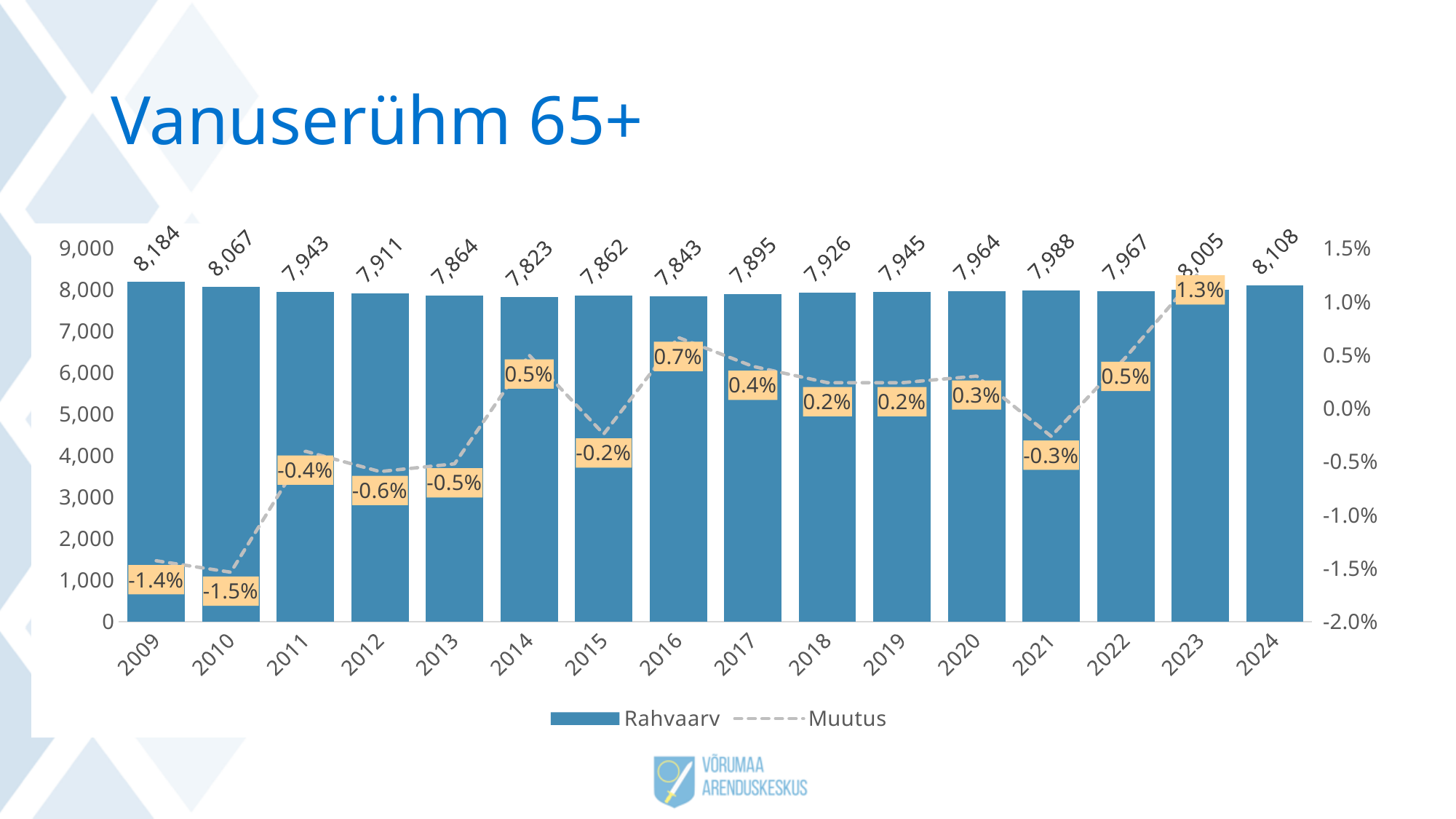
What is the title of the slide? Vanuserühm 65+ What is the Rahvaarv value for 2024? 8,108 How many years are shown on the x axis? 16 What is the Muutus value for 2023? 1.3% Which year has the lowest Rahvaarv value? 2014 How many series does the legend list? 2 What is the Muutus value for 2012? -0.6% Which year has the lowest Muutus value? 2010 What is the Rahvaarv value for 2009? 8,184 Which year has the highest Rahvaarv value? 2009 Which is larger, the Rahvaarv value for 2021 or for 2022? 2021 What is the difference between the Rahvaarv values for 2024 and 2023? 103